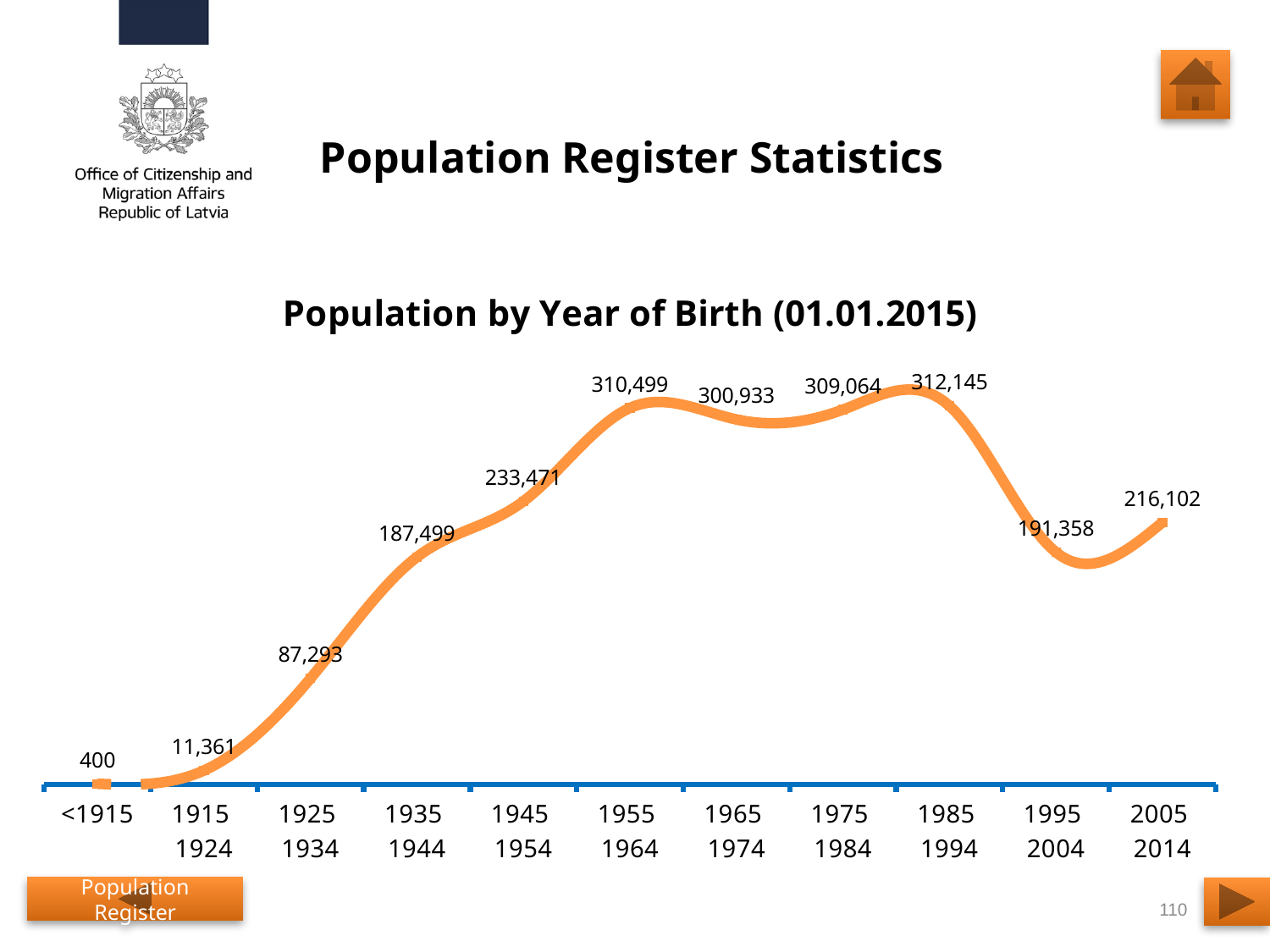
What is the population for the 1955–1964 year-of-birth group? 310,499 What is the population for the 1925–1934 year-of-birth group? 87,293 What is the population for people born before 1915 (<1915)? 400 What type of chart is used to show population by year of birth? Line chart Which year-of-birth group has the lowest population? <1915 What is the difference in population between the 1945–1954 group and the 1935–1944 group? 45,972 What is the difference in population between the 2005–2014 group and the 1995–2004 group? 24,744 What is the population for the 2005–2014 year-of-birth group? 216,102 Which year-of-birth group has the highest population? 1985–1994 What is the title of the chart? Population by Year of Birth (01.01.2015) How many year-of-birth groups are plotted on the chart? 11 Which has a larger population: the 1965–1974 group or the 1995–2004 group? 1965–1974